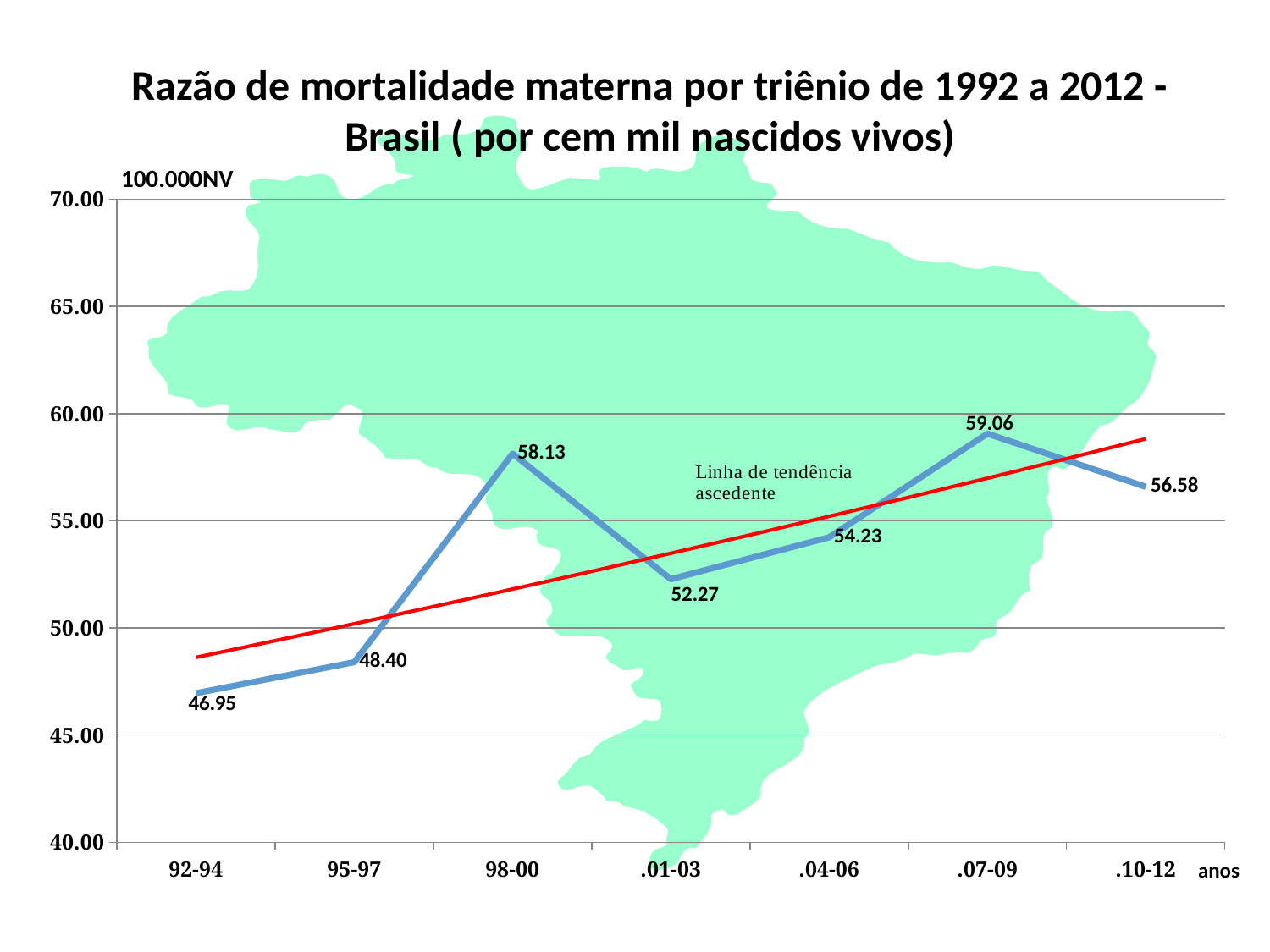
What is the value plotted for the 98-00 triennium? 58.13 What is the difference between the values for .07-09 and .01-03? 6.79 What does the text label next to the red line say? Linha de tendência ascedente What kind of chart is shown on the slide? line chart Which is larger, the value for 98-00 or the value for .04-06? 98-00 Does the value rise or fall from 92-94 to 98-00? rise What is the maternal mortality ratio for the 92-94 triennium? 46.95 What is the value plotted for the .10-12 triennium? 56.58 Is the value for 95-97 greater or less than 50.00? less How many trienniums are plotted on the x axis? 7 Which triennium has the highest maternal mortality ratio? .07-09 Which triennium has the lowest maternal mortality ratio? 92-94